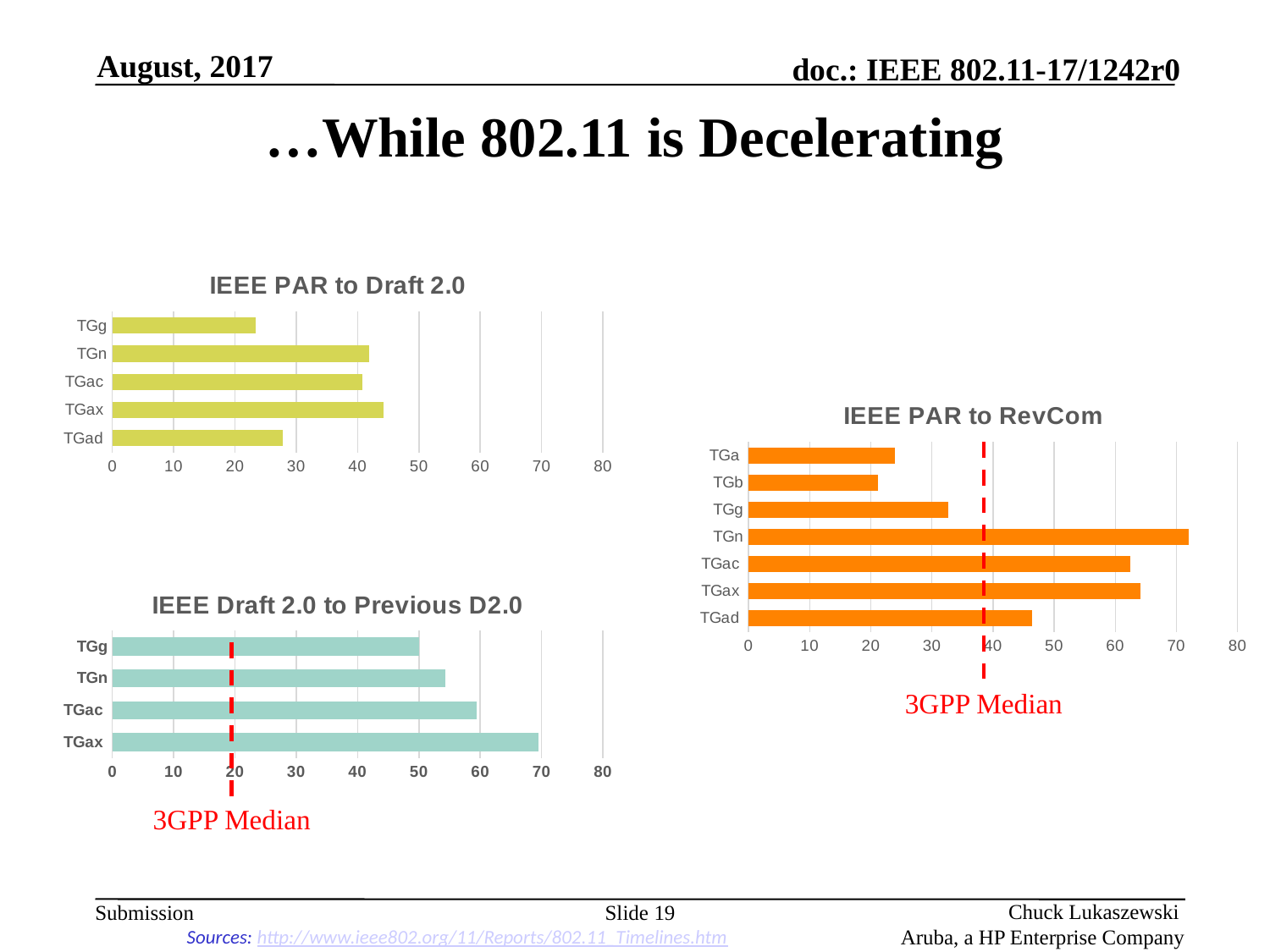
In the 'IEEE Draft 2.0 to Previous D2.0' chart, which task group has the highest value? TGax How many task groups are shown in the 'IEEE Draft 2.0 to Previous D2.0' chart? 4 In the 'IEEE PAR to Draft 2.0' chart, which is larger, the value for TGn or the value for TGad? TGn In the 'IEEE PAR to Draft 2.0' chart, which task group has the lowest value? TGg How many task groups are shown in the 'IEEE PAR to RevCom' chart? 7 In the 'IEEE PAR to RevCom' chart, which task group has the highest value? TGn In the 'IEEE PAR to Draft 2.0' chart, is the value for TGax greater or less than 40? greater In the 'IEEE PAR to RevCom' chart, is the value for TGn greater or less than 70? greater In the 'IEEE PAR to RevCom' chart, is the value for TGa greater or less than 30? less In the 'IEEE PAR to RevCom' chart, which task group has the lowest value? TGb What does the red dashed vertical line in the 'IEEE PAR to RevCom' chart represent? 3GPP Median